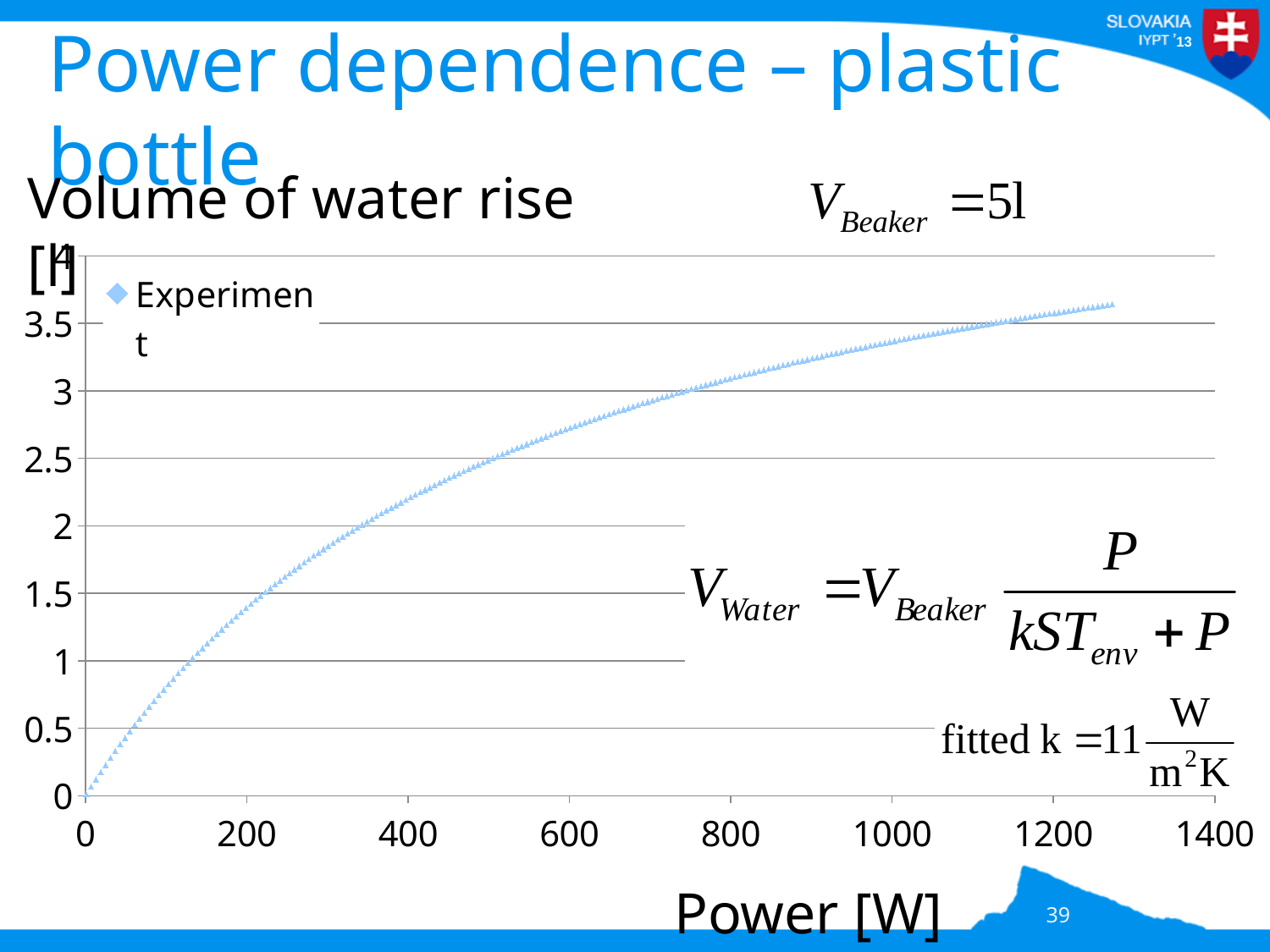
Is the volume of water rise at 1000 W greater or less than 3 l? greater What is the highest value shown on the x axis of the chart? 1400 Does the volume of water rise increase or decrease as power increases along the x axis? increase What is the name of the series shown in the chart legend? Experiment How many series does the chart legend list? 1 Is the volume of water rise at 200 W greater or less than 2 l? less Is the volume of water rise at 1200 W greater or less than 4 l? less What kind of chart is shown on the slide? scatter chart What is the label of the x axis of the chart? Power [W] Which has the larger volume of water rise: 400 W or 1000 W? 1000 W